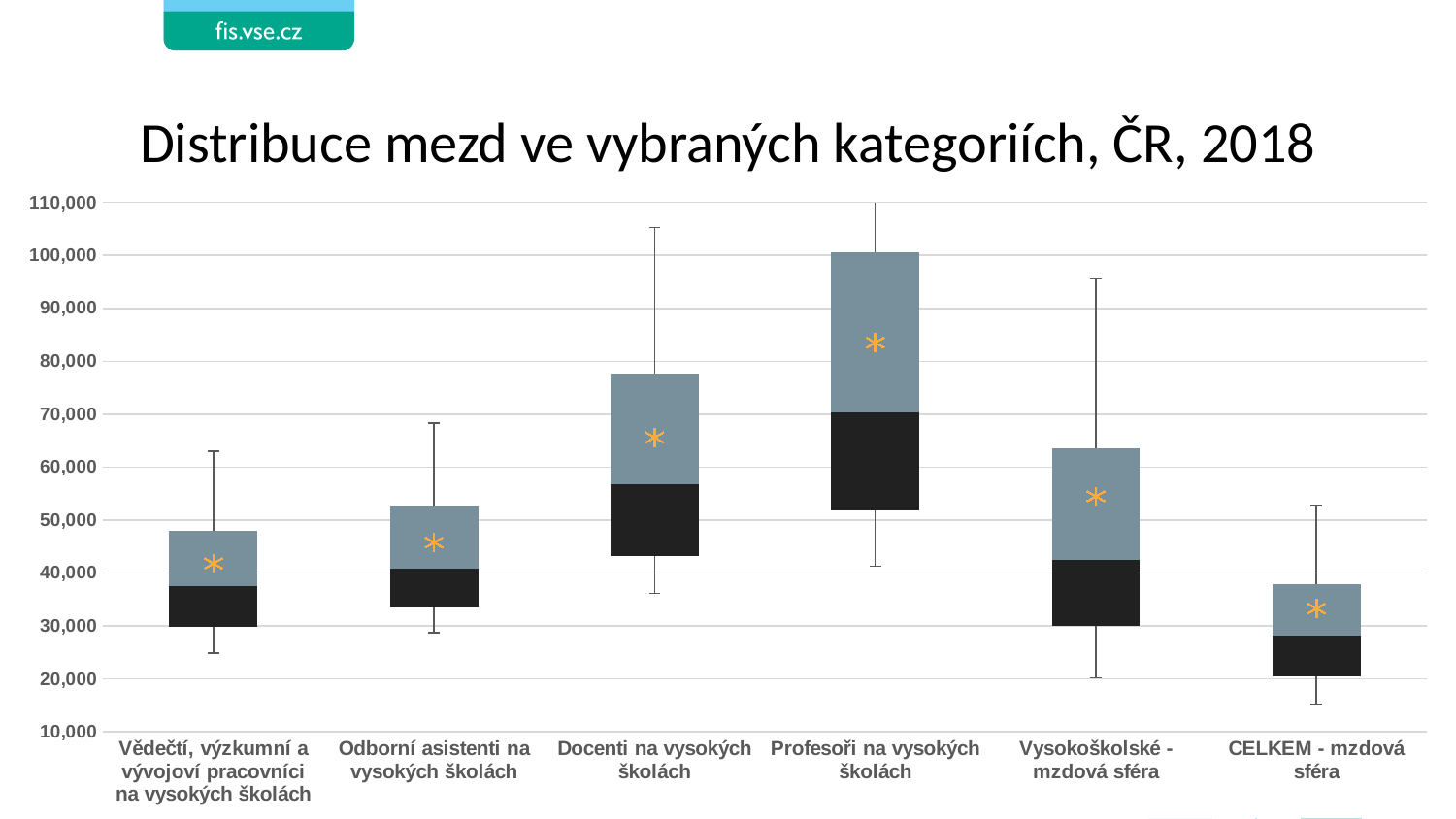
Is the mean marker for Odborní asistenti na vysokých školách greater or less than 50,000? less Is the mean marker for Docenti na vysokých školách greater or less than 60,000? greater Which category has the lowest mean marker (orange asterisk)? CELKEM - mzdová sféra Which category has the highest mean marker (orange asterisk)? Profesoři na vysokých školách What is the highest value shown on the vertical axis? 110,000 Is the top of the upper whisker for Docenti na vysokých školách greater or less than 100,000? greater How many categories are shown along the x axis? 6 What kind of chart is shown on the slide? Box plot (box-and-whisker chart) Which has the higher mean marker: Docenti na vysokých školách or Odborní asistenti na vysokých školách? Docenti na vysokých školách What is the title of the chart? Distribuce mezd ve vybraných kategoriích, ČR, 2018